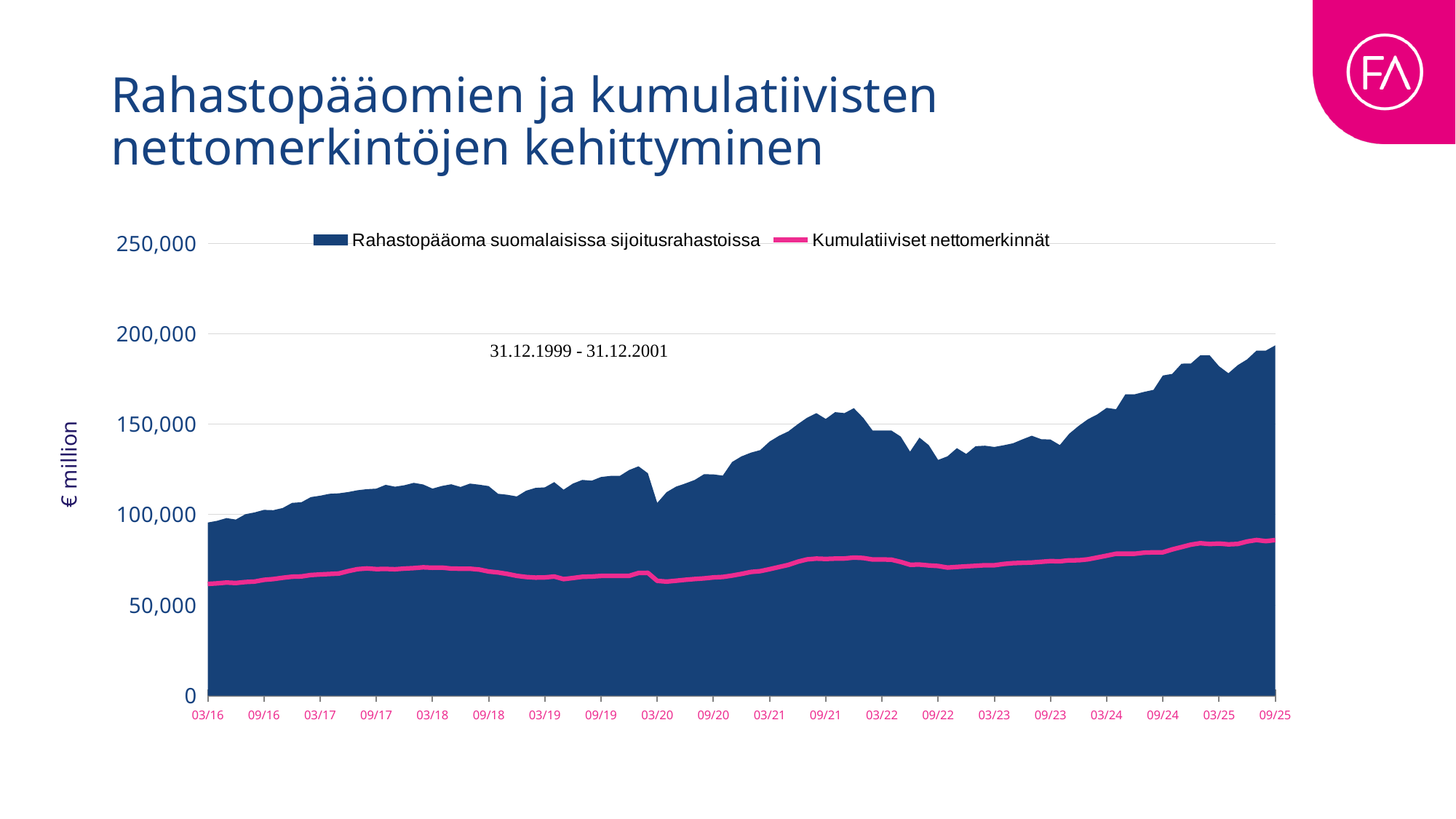
Is the value of Rahastopääoma suomalaisissa sijoitusrahastoissa at 09/25 greater or less than 150,000? greater Is the value of Rahastopääoma suomalaisissa sijoitusrahastoissa at 03/16 greater or less than 100,000? less At 09/25, which series has the higher value: Rahastopääoma suomalaisissa sijoitusrahastoissa or Kumulatiiviset nettomerkinnät? Rahastopääoma suomalaisissa sijoitusrahastoissa What is the label on the vertical axis of the chart? € million Is the value of Kumulatiiviset nettomerkinnät at 03/16 greater or less than 50,000? greater Overall, does Rahastopääoma suomalaisissa sijoitusrahastoissa rise or fall from 03/16 to 09/25? rise What kind of chart is used to show Rahastopääoma suomalaisissa sijoitusrahastoissa? area chart How many date labels are shown on the x axis? 20 What kind of chart is used to show Kumulatiiviset nettomerkinnät? line chart At which x-axis label is Rahastopääoma suomalaisissa sijoitusrahastoissa at its lowest? 03/16 How many series does the chart legend list? 2